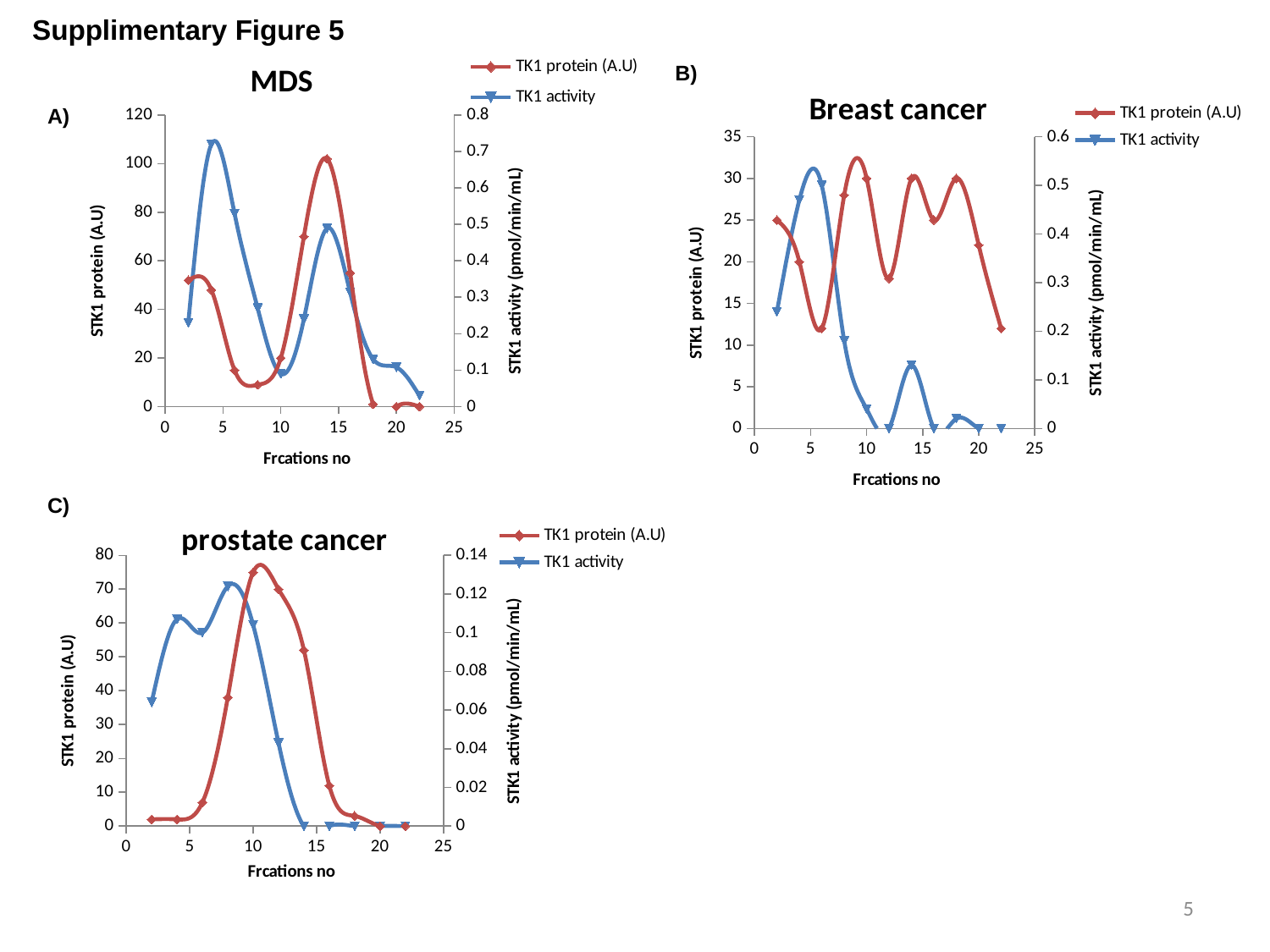
In the MDS chart, how many data points are plotted for the TK1 protein (A.U) series? 11 In the MDS chart, is the TK1 activity value at fraction 4 greater or less than 0.6? greater How many series does the legend of the Breast cancer chart list? 2 What kind of chart is the MDS chart (panel A)? line chart In the prostate cancer chart, is the TK1 protein (A.U) value at fraction 10 greater or less than 60? greater What is the x-axis label of the prostate cancer chart? Frcations no In the Breast cancer chart, is the TK1 protein (A.U) value at fraction 10 greater or less than 25? greater In the prostate cancer chart, at which fraction number does TK1 activity reach its highest value? 8 In the MDS chart, at which fraction number does TK1 protein (A.U) reach its highest value? 14 In the MDS chart, which is larger: the TK1 protein (A.U) value at fraction 2 or at fraction 8? fraction 2